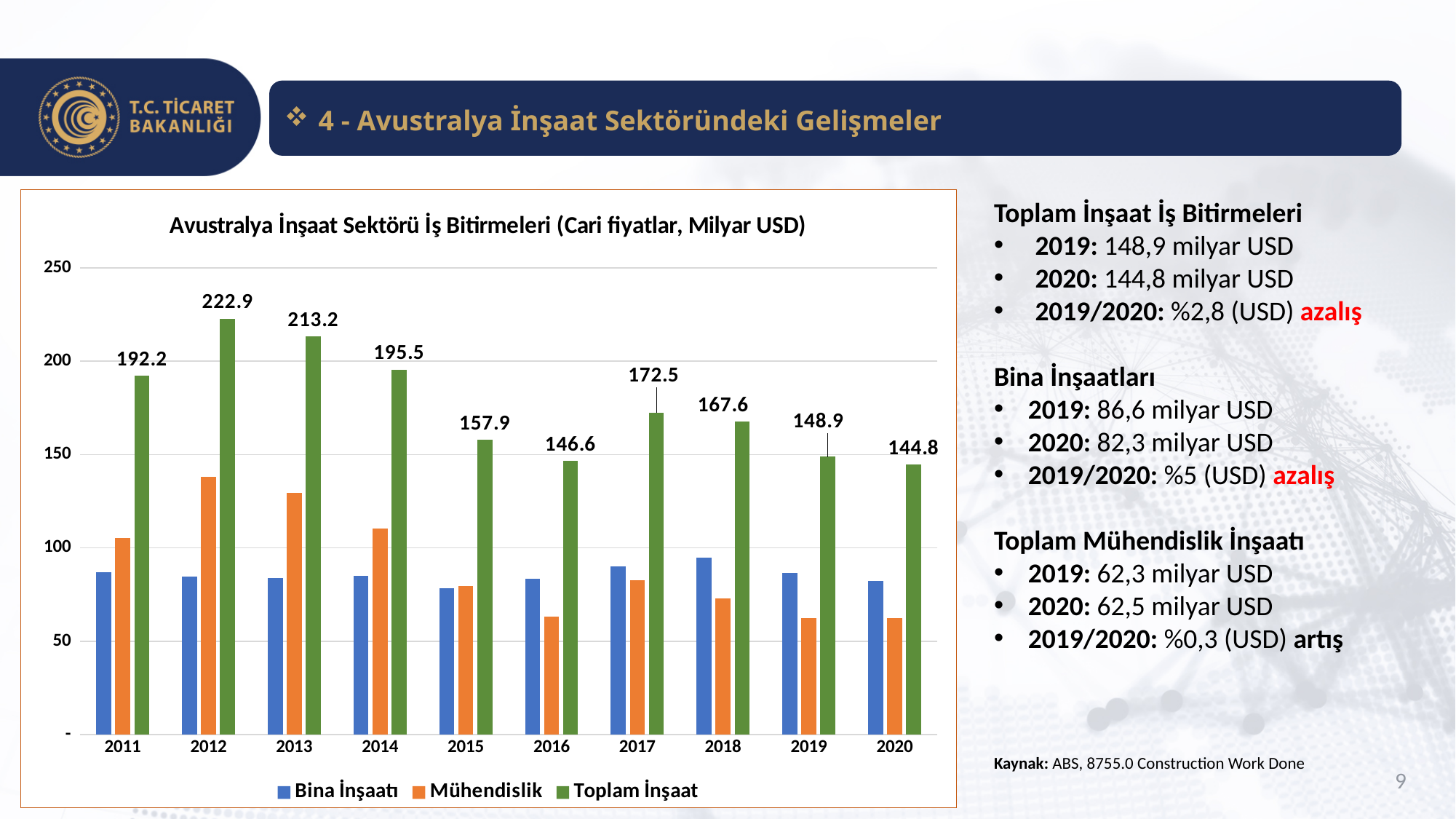
How many years are shown on the x axis? 10 What kind of chart is shown? Bar chart In which year is Toplam İnşaat highest? 2012 In which year is Toplam İnşaat lowest? 2020 Which is larger, Toplam İnşaat in 2013 or in 2014? 2013 What is the value of Toplam İnşaat for 2020? 144.8 Is the value for Mühendislik in 2012 greater or less than 100? greater Is the value for Bina İnşaatı in 2018 greater or less than 100? less What is the value of Toplam İnşaat for 2012? 222.9 What is the value of Toplam İnşaat for 2017? 172.5 How many series does the legend list? 3 What is the difference between the Toplam İnşaat values for 2019 and 2020? 4.1